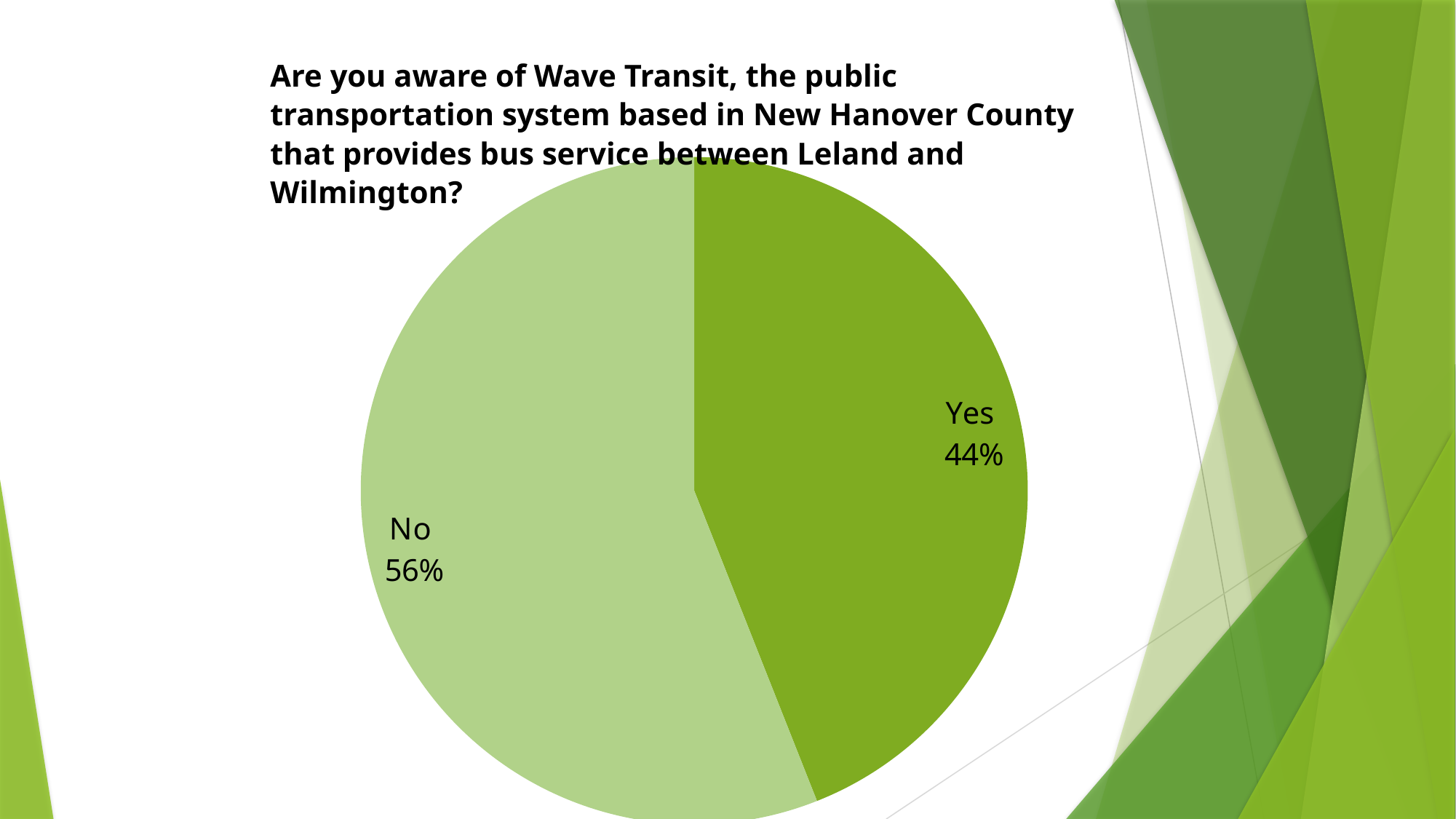
Which response has the larger share of the pie, Yes or No? No Is the share for Yes larger or smaller than the share for No? smaller What percentage of respondents answered "No" to being aware of Wave Transit? 56% Is the share for No greater or less than 50%? greater Which response has the smaller share of the pie? Yes What is the difference in percentage points between the No and Yes responses? 12 Which slice is shown in the darker green colour? Yes How many slices does the pie chart have? 2 What share of the pie does the No slice represent? 56% What question does the chart title ask respondents about? Whether they are aware of Wave Transit, the public transportation system based in New Hanover County that provides bus service between Leland and Wilmington What kind of chart is shown on the slide? pie chart What percentage of respondents answered "Yes" to being aware of Wave Transit? 44%